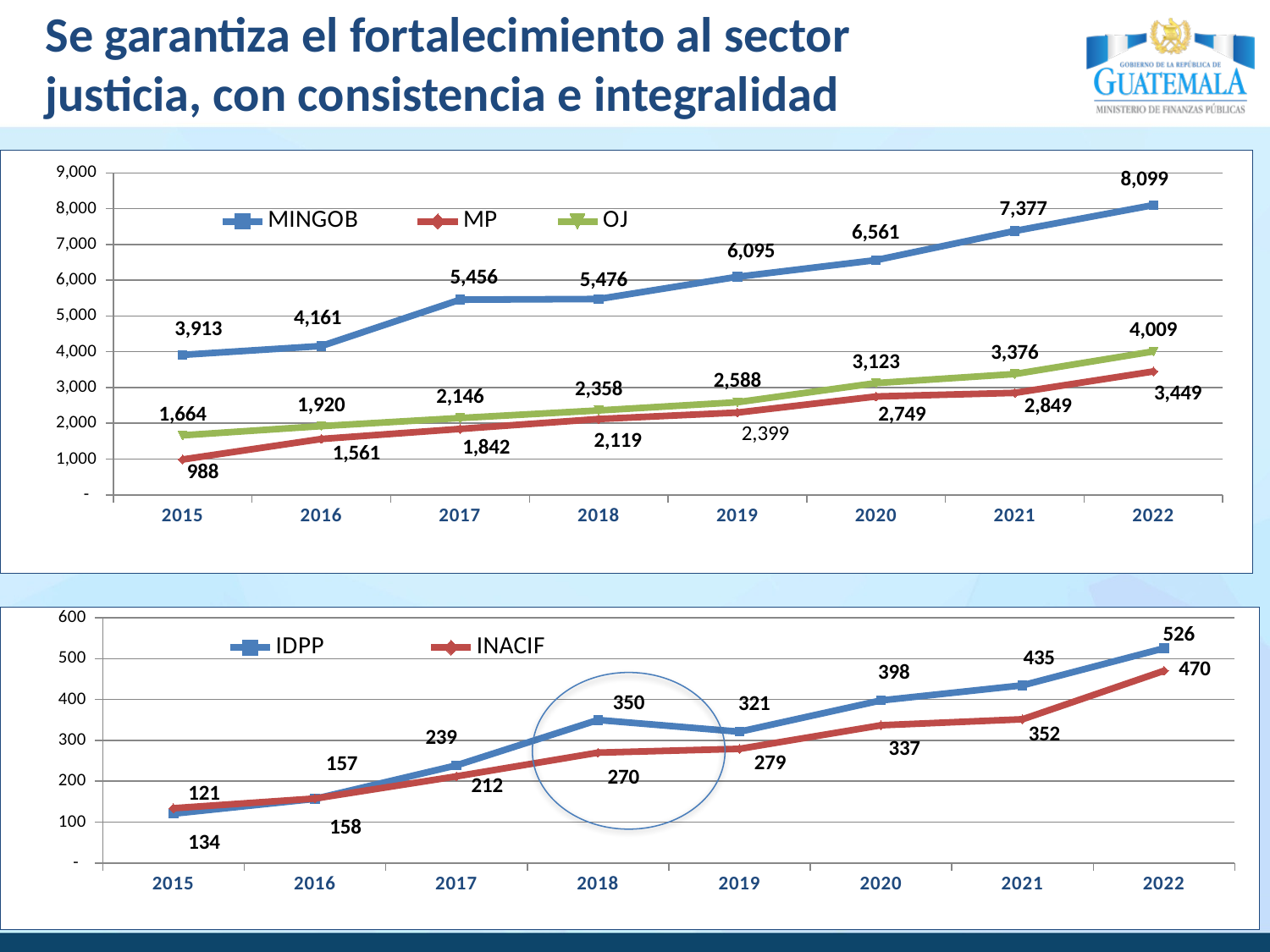
In the bottom chart, which is larger in 2021, IDPP or INACIF? IDPP In the bottom chart, what is the value for INACIF in 2022? 470 In the top chart, how many series does the legend list? 3 In the bottom chart, what is the value for IDPP in 2018? 350 In the bottom chart, how many years are shown on the x axis? 8 In the top chart, what is the value for MINGOB in 2022? 8,099 In the top chart, does the MINGOB series rise or fall from 2015 to 2022? rise In the top chart, what is the value for OJ in 2020? 3,123 What type of chart is the bottom chart? line chart In the top chart, what is the value for MP in 2015? 988 In the top chart, which series has the highest value in 2022? MINGOB In the top chart, what is the difference between the MINGOB values for 2022 and 2015? 4,186